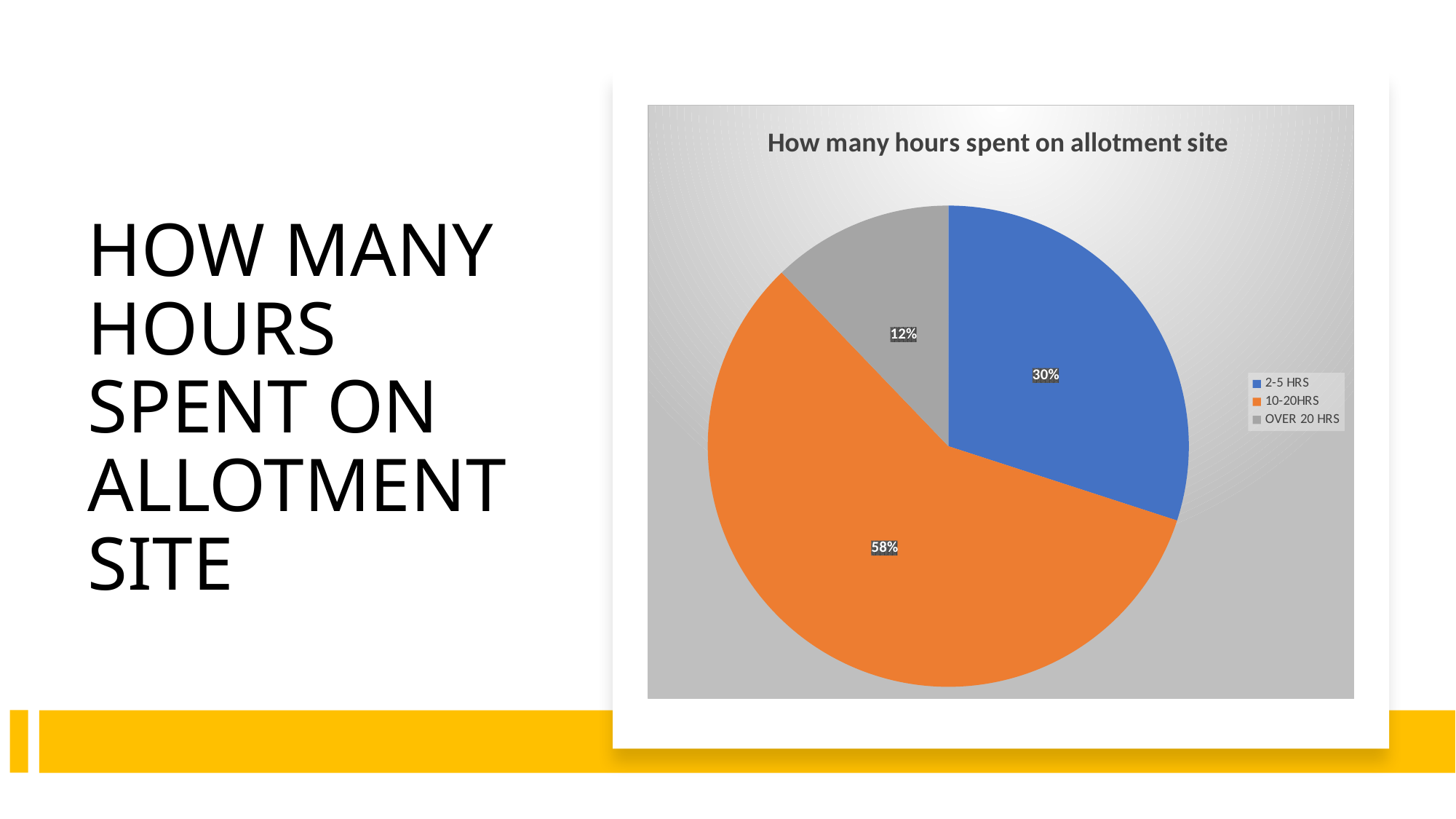
How many categories does the legend list? 3 What colour is the 10-20HRS slice? orange What percentage of the pie is the 10-20HRS slice? 58% Which category has the largest share of the pie? 10-20HRS What is the difference in percentage points between the 10-20HRS slice and the 2-5 HRS slice? 28 What is the title of the chart? How many hours spent on allotment site What kind of chart is shown on the slide? pie chart Which is larger, the 2-5 HRS slice or the OVER 20 HRS slice? 2-5 HRS Which category has the smallest share of the pie? OVER 20 HRS What percentage of the pie is the OVER 20 HRS slice? 12% What is the difference in percentage points between the 2-5 HRS slice and the OVER 20 HRS slice? 18 What percentage of the pie is the 2-5 HRS slice? 30%